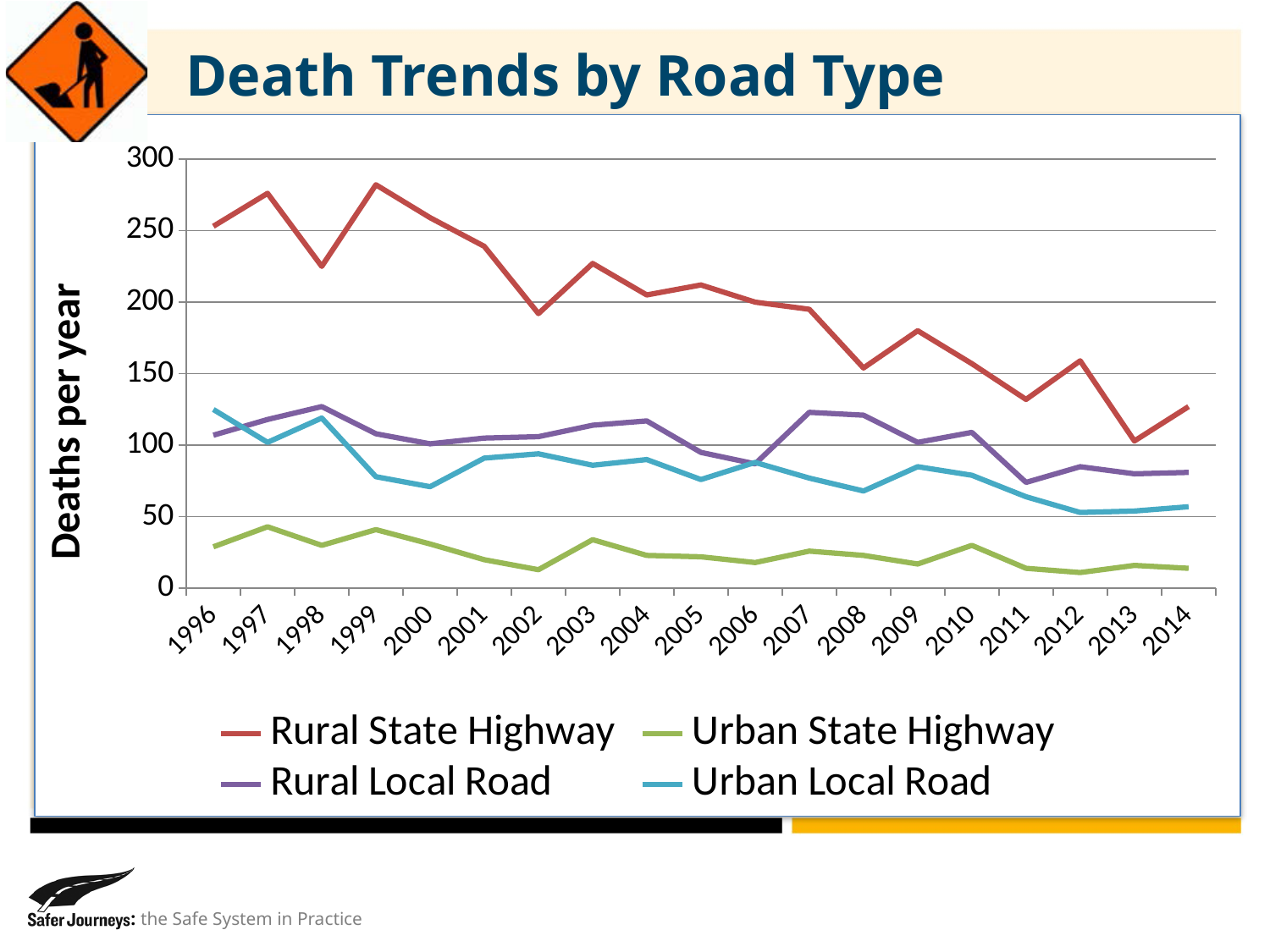
Which road type has the highest deaths per year across the whole period? Rural State Highway In 2014, which is larger: Rural Local Road or Urban Local Road? Rural Local Road What kind of chart is shown on the slide? Line chart In which year does the Rural State Highway line reach its lowest point? 2013 Is the value for Rural State Highway in 1999 greater or less than 250? greater Is the value for Urban Local Road in 2012 greater or less than 100? less How many years are plotted along the x axis? 19 What is the label on the vertical axis? Deaths per year Is the value for Urban State Highway in 2002 greater or less than 50? less Which road type has the lowest deaths per year across the whole period? Urban State Highway How many series does the legend list? 4 Does the Rural State Highway line generally rise or fall from 1996 to 2014? Fall